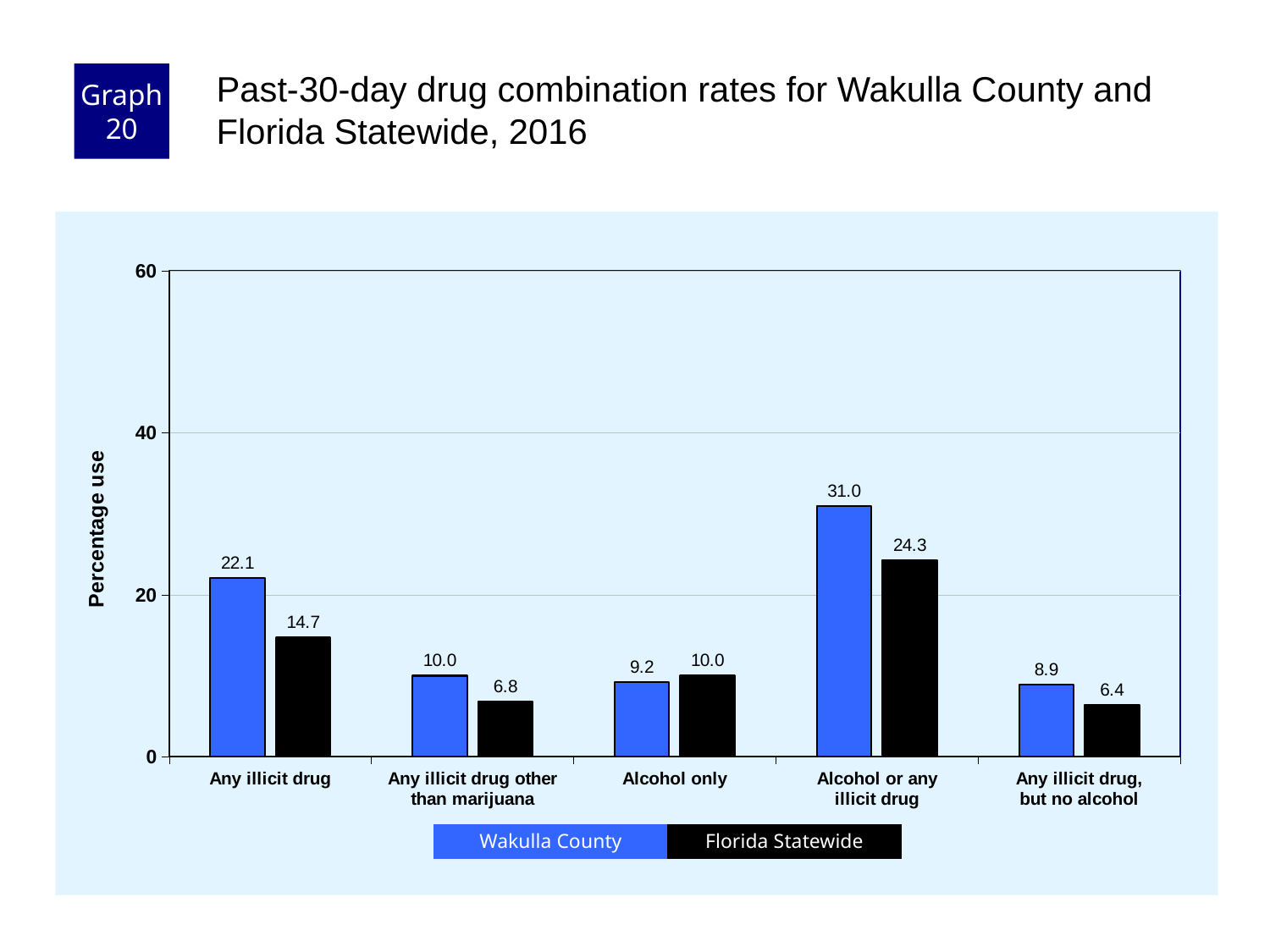
What is the Wakulla County value for Any illicit drug? 22.1 Is the Wakulla County value for Alcohol or any illicit drug greater or less than 20? greater How many categories are shown on the x axis? 5 Which is larger for Alcohol only: Wakulla County or Florida Statewide? Florida Statewide What is the difference between the Wakulla County and Florida Statewide values for Any illicit drug? 7.4 What is the Florida Statewide value for Alcohol or any illicit drug? 24.3 What is the Florida Statewide value for Any illicit drug, but no alcohol? 6.4 What kind of chart is shown on the slide? bar chart Which category has the lowest Florida Statewide value? Any illicit drug, but no alcohol How many series does the legend list? 2 Which category has the highest Wakulla County value? Alcohol or any illicit drug What is the label of the y axis? Percentage use